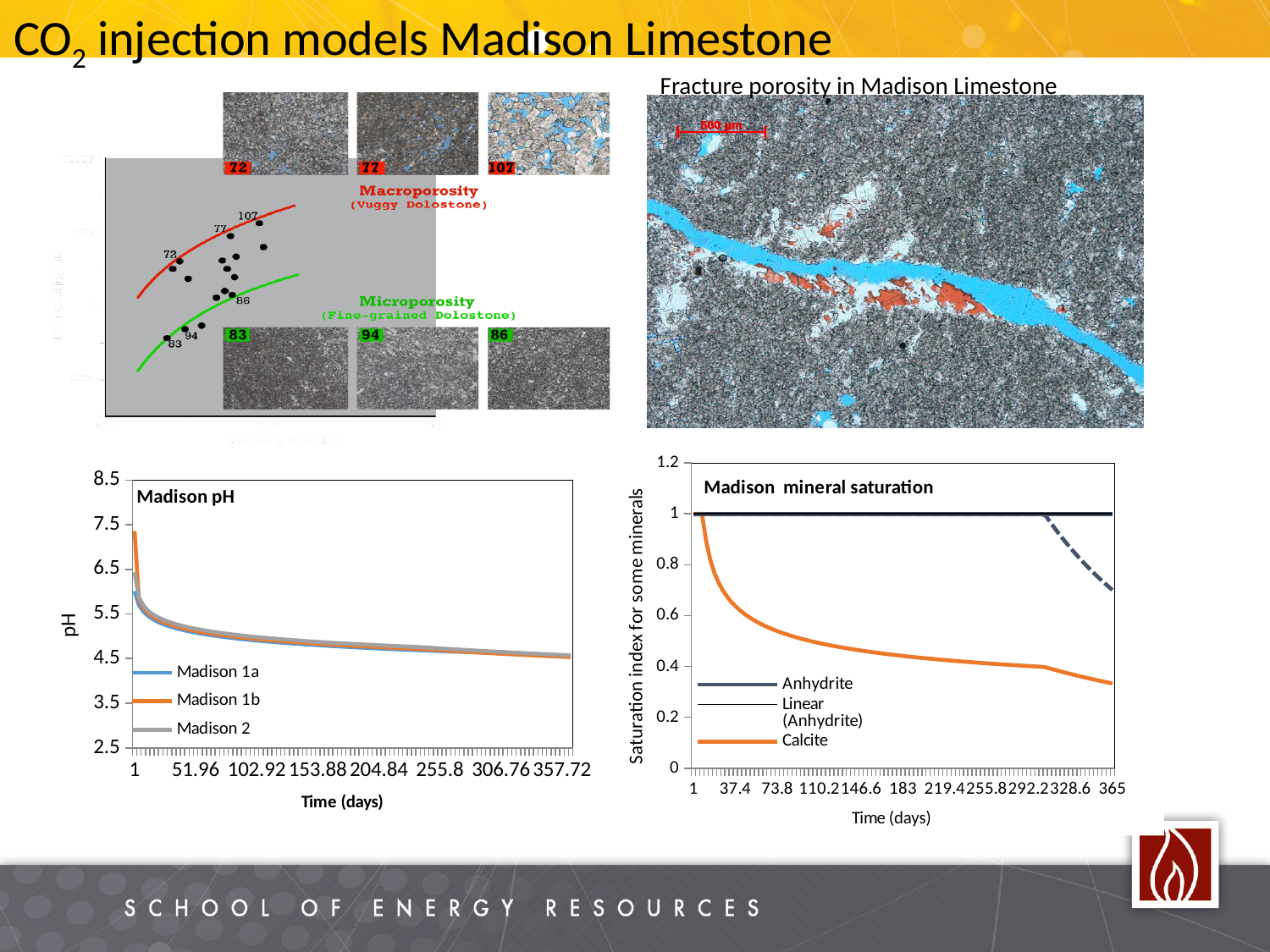
In the Madison mineral saturation chart, is the saturation index for Calcite at day 365 greater or less than 0.4? less In the Madison mineral saturation chart, what is the saturation index for Anhydrite at day 1? 1 How many series does the legend of the Madison pH chart list? 3 How many entries does the legend of the Madison mineral saturation chart list? 3 In the Madison mineral saturation chart, does the Calcite saturation index rise or fall over time? fall In the Madison pH chart, does the pH rise or fall over time? fall In the Madison pH chart, is the pH for Madison 1b at day 1 greater or less than 6.5? greater In the Madison mineral saturation chart, which has the higher saturation index at day 365, Anhydrite or Calcite? Anhydrite In the Madison pH chart, is the pH for Madison 1a at day 204.84 greater or less than 5.5? less What is the x-axis title of the Madison pH chart? Time (days) What kind of chart is the Madison pH chart? line chart What kind of chart is the Madison mineral saturation chart? line chart